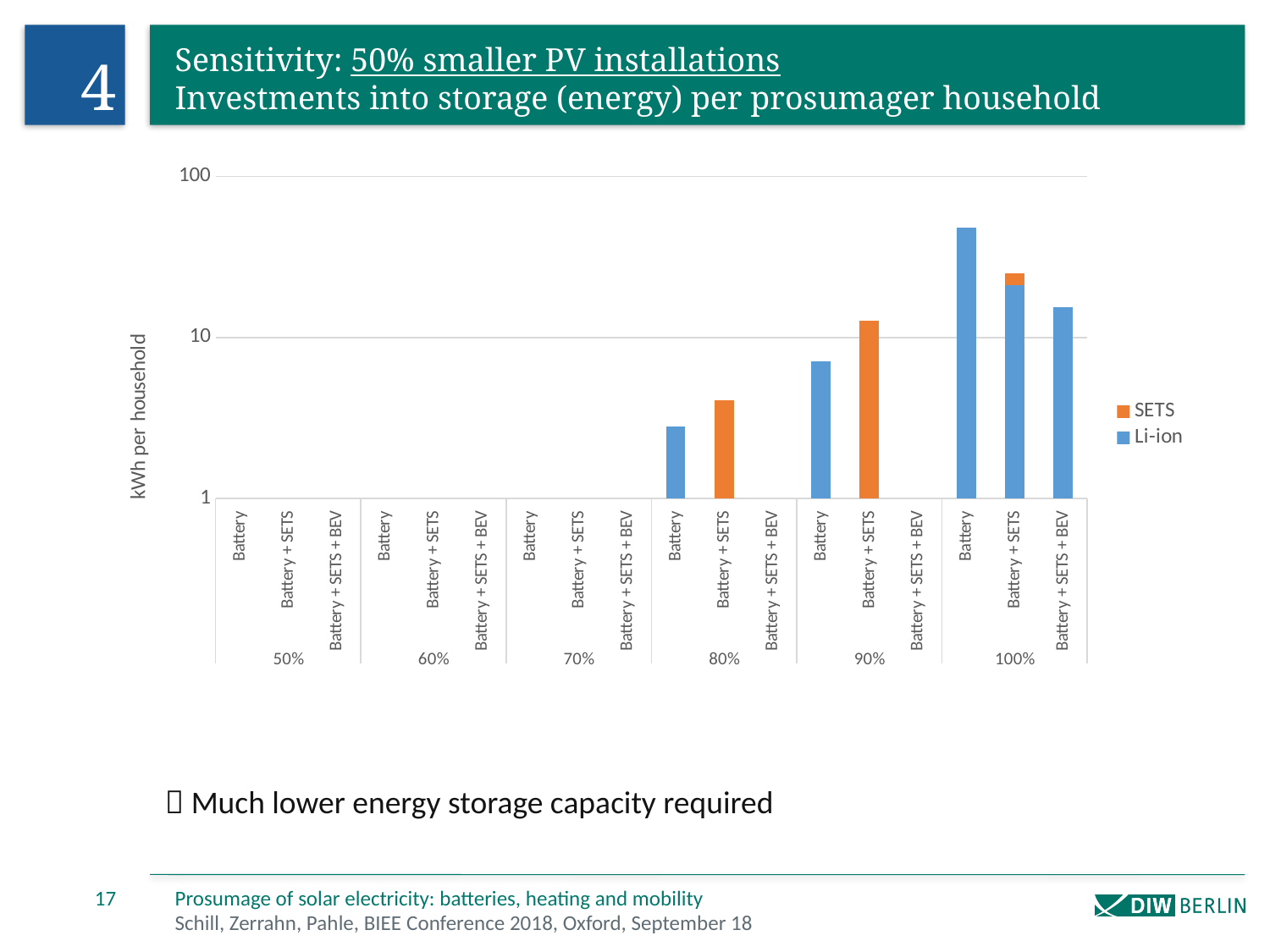
Do the Battery bars rise or fall from the 80% group to the 100% group? rise Is the value for Battery at 90% greater or less than 10? less Which series is shown in orange in the legend? SETS What is the label of the vertical axis? kWh per household How many percentage groups (50% to 100%) are shown along the x axis? 6 Is the value for Battery at 100% greater or less than 10? greater Is the value for Battery + SETS + BEV at 100% greater or less than 10? greater Which bar is the tallest in the chart? Battery at 100% Which is larger: the Battery bar at 80% or the Battery + SETS bar at 80%? Battery + SETS at 80% How many series does the legend list? 2 What kind of chart is shown on the slide? Stacked bar chart